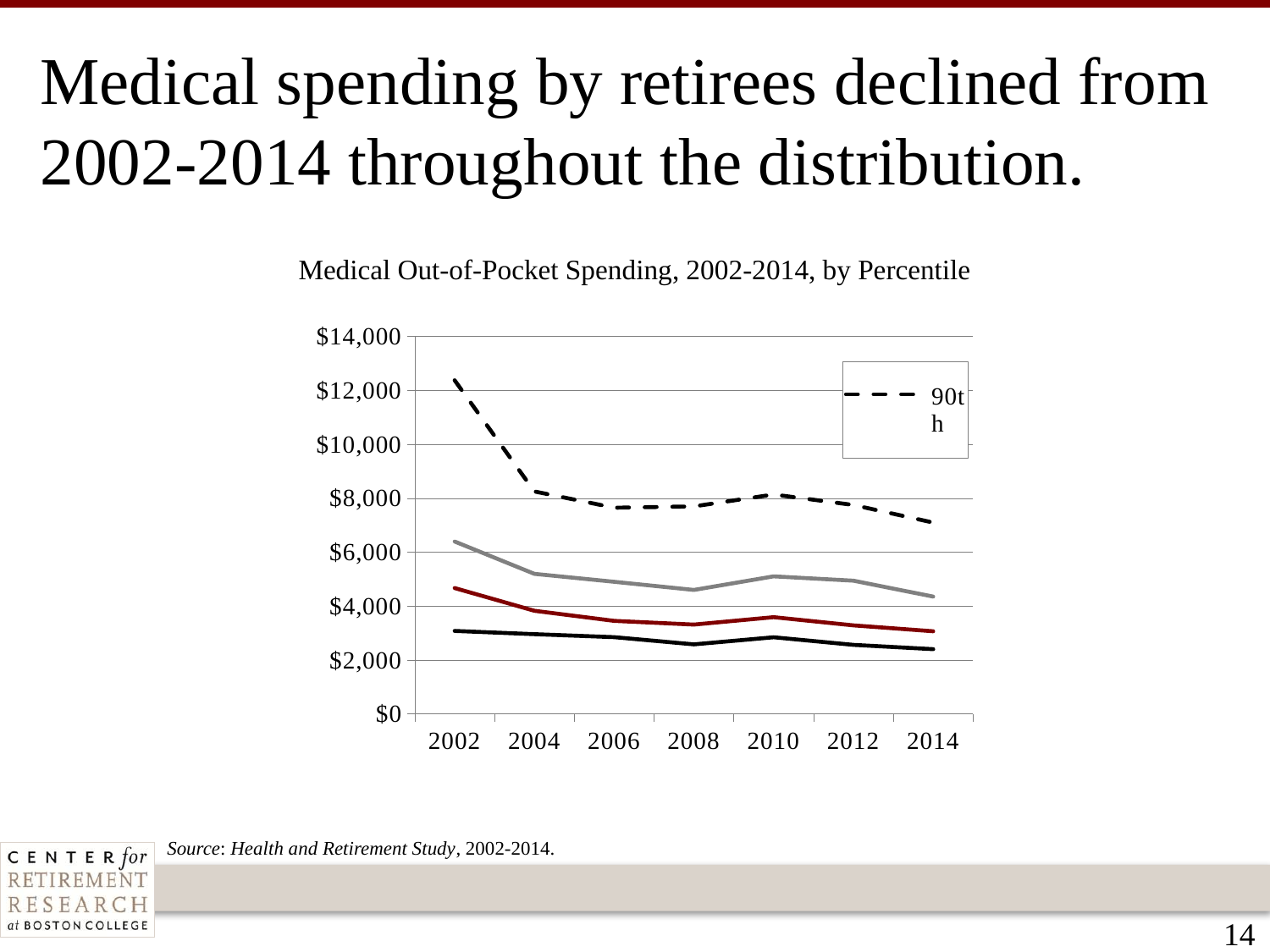
In which year is the 90th percentile value highest? 2002 Is the value of the lowest (solid black) line in 2014 greater or less than $4,000? less What kind of chart is shown on the slide? line chart Is the 90th percentile value larger in 2002 or in 2014? 2002 Is the 90th percentile value in 2002 greater or less than $10,000? greater Is the 90th percentile value in 2014 greater or less than $8,000? less How many years are labeled on the x axis of the chart? 7 How many lines are plotted on the chart? 4 Does the 90th percentile line rise or fall from 2002 to 2014? fall What is the title of the chart? Medical Out-of-Pocket Spending, 2002-2014, by Percentile In which year is the 90th percentile value lowest? 2014 Which series is named in the chart's legend? 90th